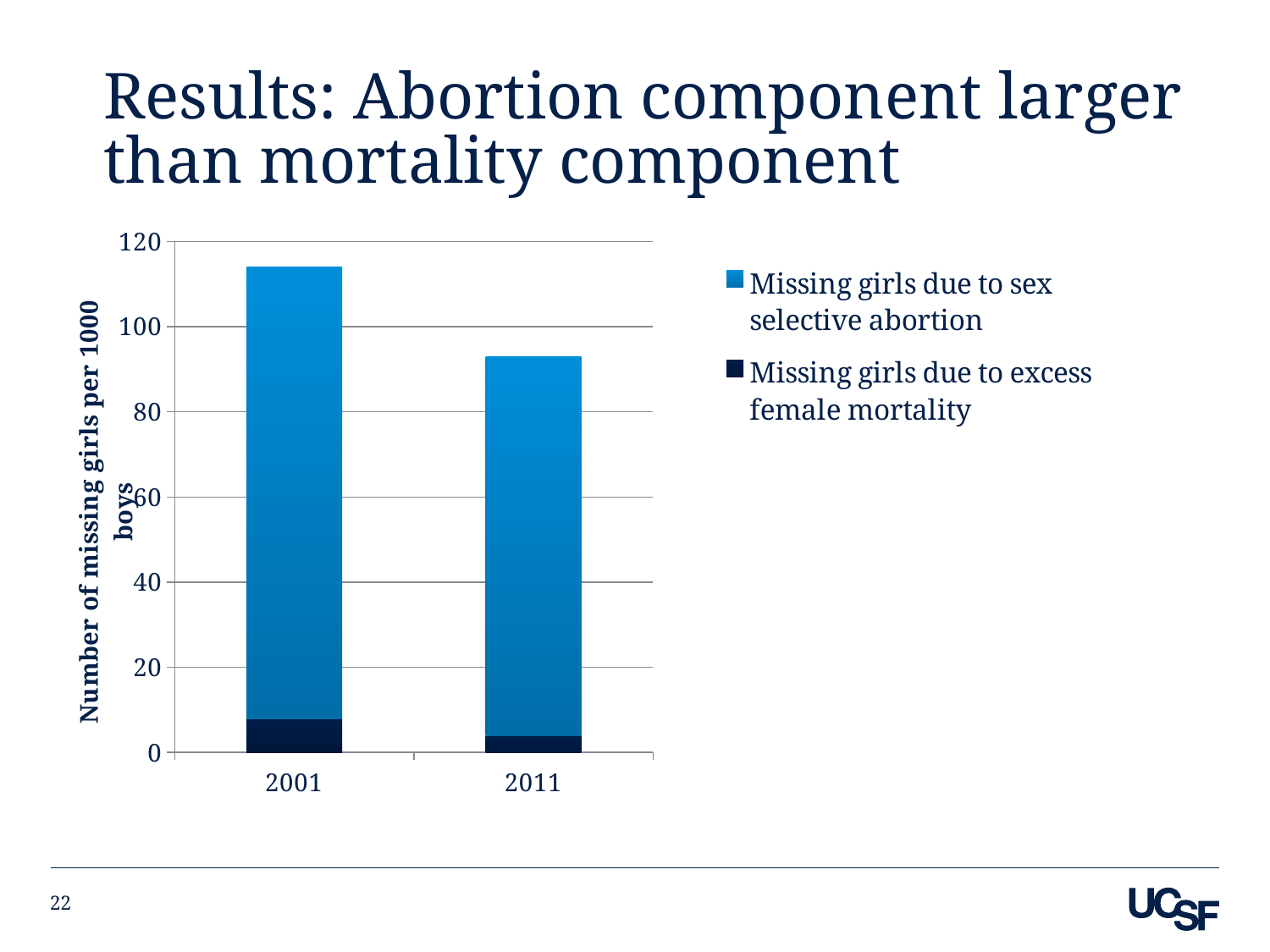
Which legend entry is shown in the dark navy colour? Missing girls due to excess female mortality What is the title of the y axis of the chart? Number of missing girls per 1000 boys Which year has the taller stacked bar, 2001 or 2011? 2001 Is the total height of the 2011 bar greater or less than 80? greater Is the total height of the 2011 bar greater or less than 100? less What kind of chart is shown on the slide? stacked bar chart Do the total values rise or fall from 2001 to 2011? fall Which year has the larger 'Missing girls due to excess female mortality' segment, 2001 or 2011? 2001 Is the 'Missing girls due to excess female mortality' segment for 2001 greater or less than 20? less How many years are shown on the x axis of the chart? 2 How many series does the chart's legend list? 2